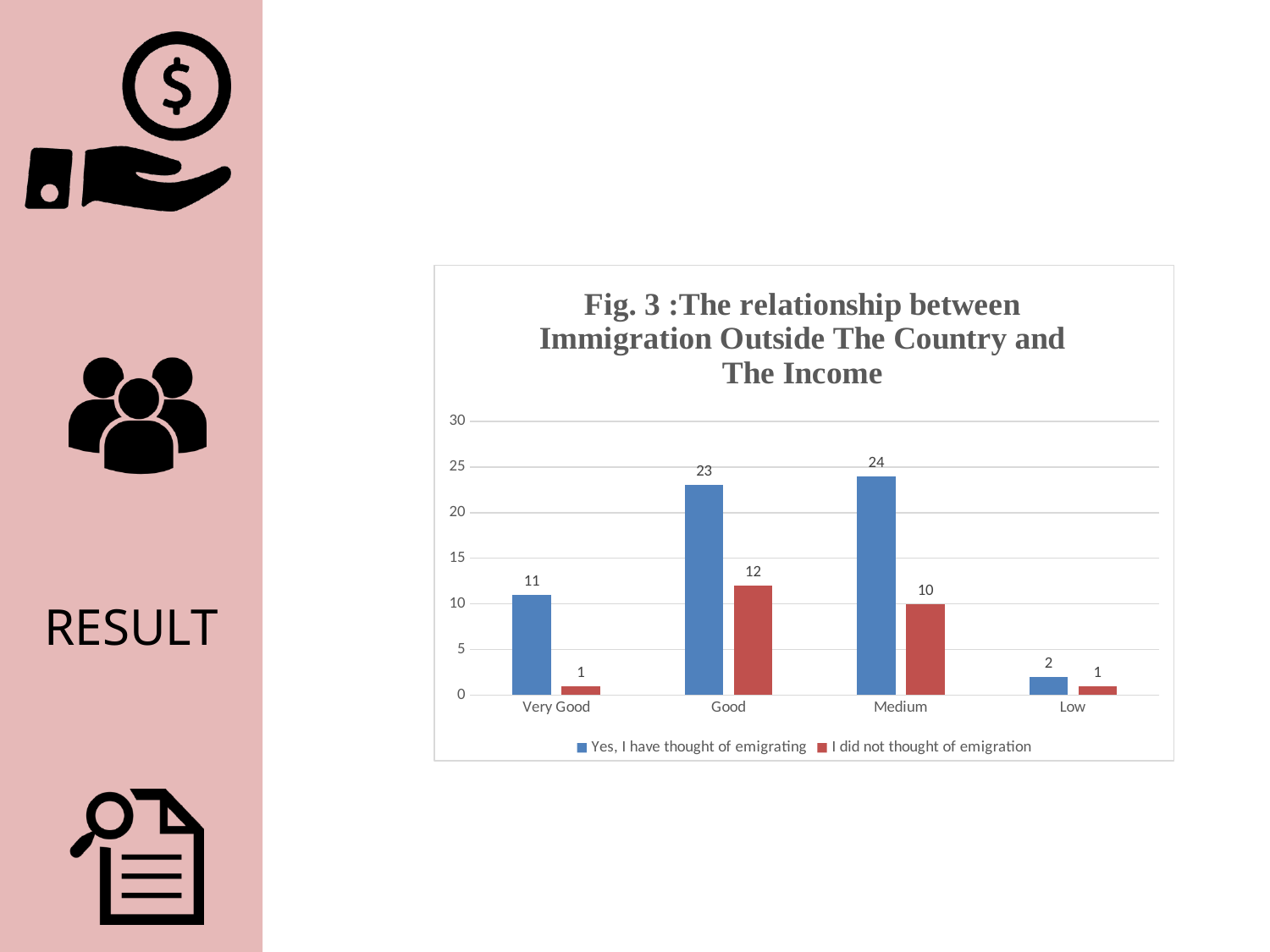
What is the value for "Yes, I have thought of emigrating" in the Good category? 23 Which category has the highest value for "Yes, I have thought of emigrating"? Medium How many series does the legend list? 2 What is the title of the chart? Fig. 3 :The relationship between Immigration Outside The Country and The Income What is the value for "I did not thought of emigration" in the Medium category? 10 What is the difference between the two series in the Very Good category? 10 Which category has the lowest value for "Yes, I have thought of emigrating"? Low How many income categories are shown on the x axis? 4 In the Good category, which series has the larger value? Yes, I have thought of emigrating What is the value for "Yes, I have thought of emigrating" in the Very Good category? 11 What kind of chart is shown on the slide? bar chart Is the value for "Yes, I have thought of emigrating" in the Medium category greater or less than 20? greater